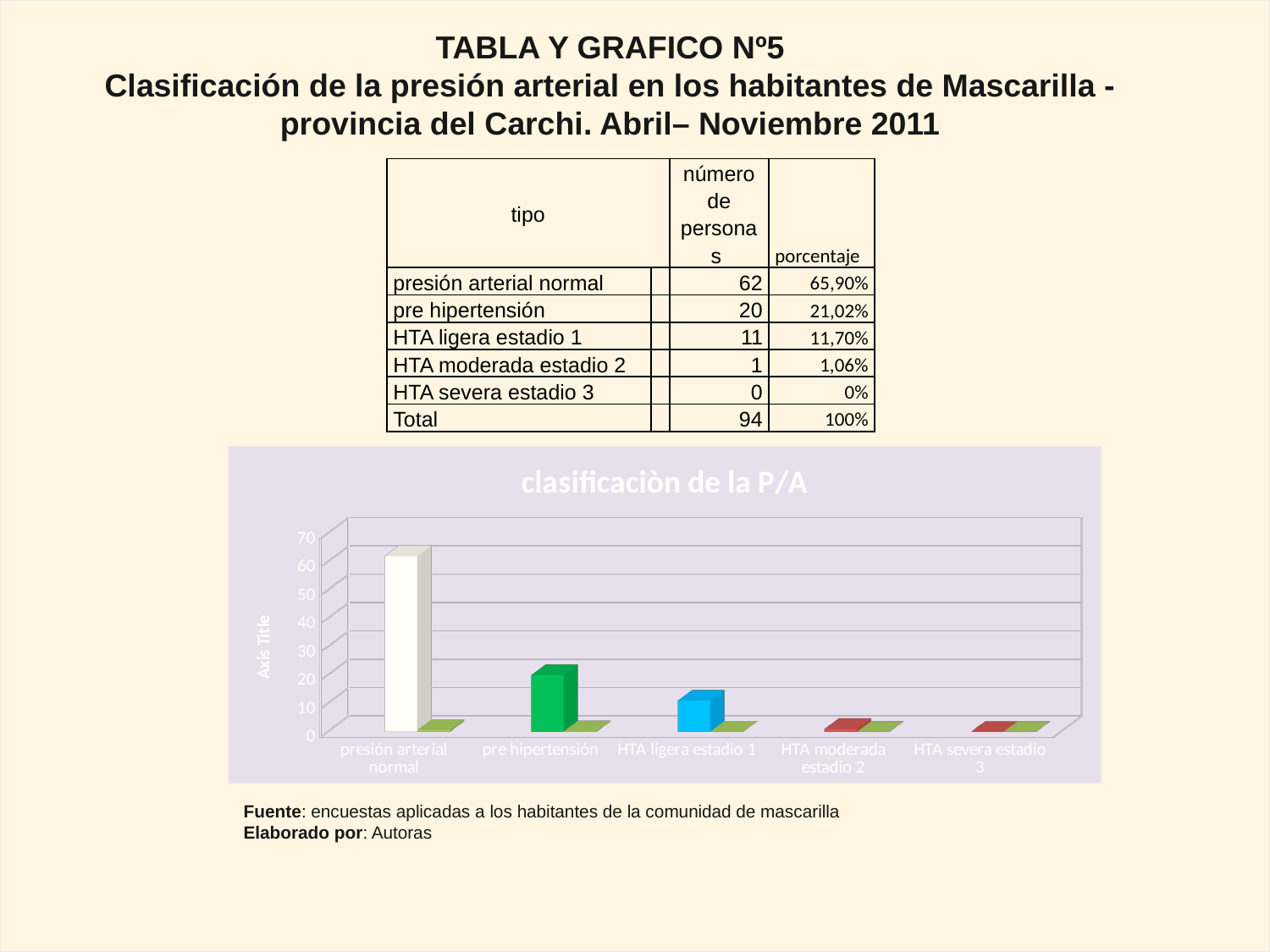
How many categories are shown on the x axis of the chart? 5 According to the table on the slide, how many people have presión arterial normal? 62 According to the table on the slide, what percentage corresponds to pre hipertensión? 21,02% Is the bar for pre hipertensión greater or less than 30? less Which category has the lowest bar in the chart? HTA severa estadio 3 What is the title of the chart? clasificaciòn de la P/A Which category has the tallest bar in the chart? presión arterial normal What kind of chart is shown on the slide? bar chart Do the bar heights rise or fall from left to right across the x axis? fall Which bar is taller, pre hipertensión or HTA ligera estadio 1? pre hipertensión Is the bar for HTA ligera estadio 1 greater or less than 20? less Is the bar for presión arterial normal greater or less than 60? greater